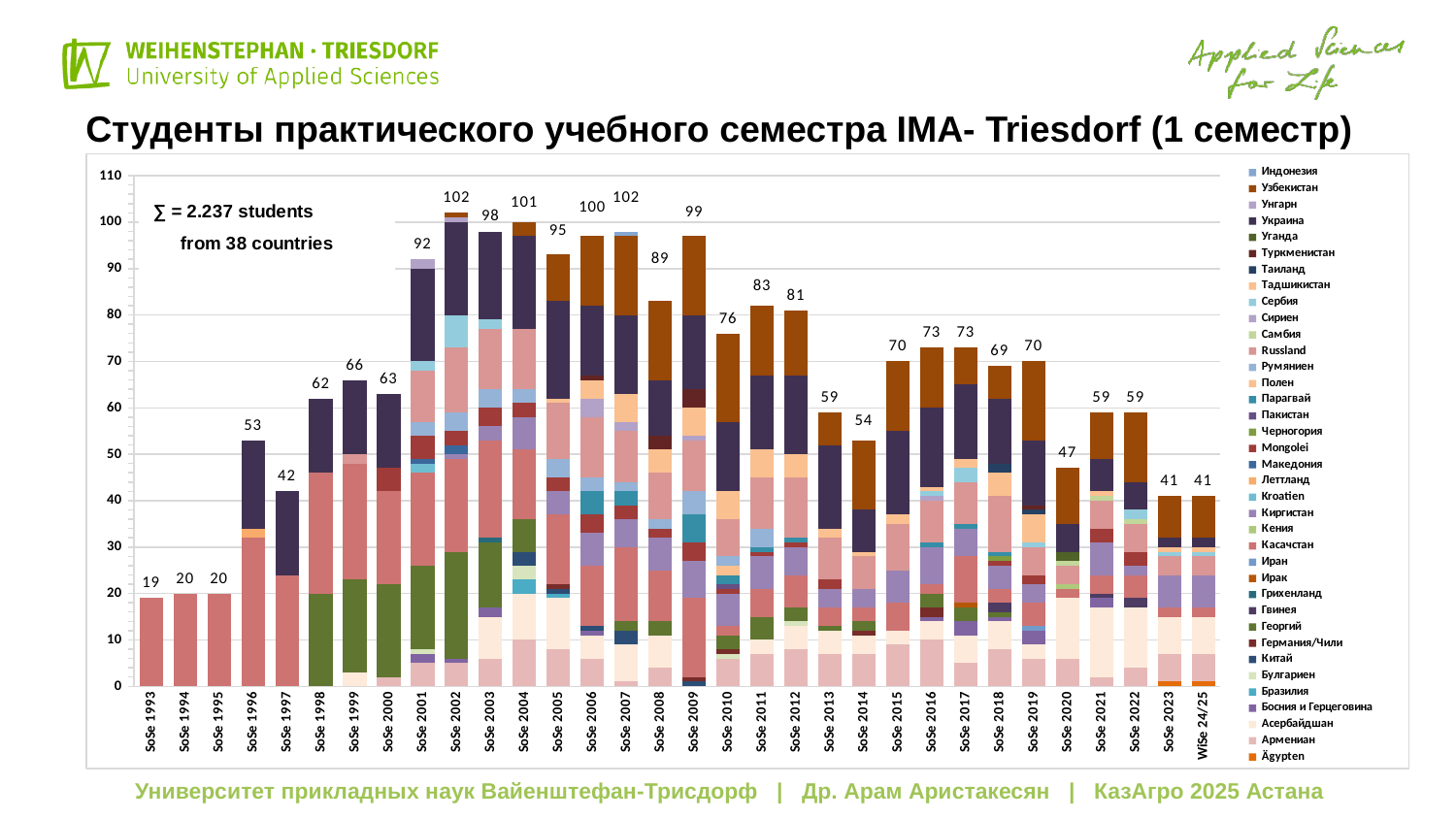
What kind of chart is shown on the slide? Stacked bar chart How many semesters (bars) are shown on the x axis? 32 What is the total number of students shown for SoSe 1996? 53 What is the total number of students shown for WiSe 24/25? 41 Which semester has a higher total, SoSe 2011 or SoSe 2012? SoSe 2011 What is the difference between the totals for SoSe 2009 and SoSe 2010? 23 According to the annotation on the chart, how many students in total and from how many countries are represented? 2.237 students from 38 countries Which semester has the lowest total number of students? SoSe 1993 What is the total number of students shown for SoSe 2002? 102 Is the total for SoSe 2005 greater or less than 90? greater What is the total number of students shown for SoSe 2014? 54 What is the difference between the totals for SoSe 2001 and SoSe 2020? 45